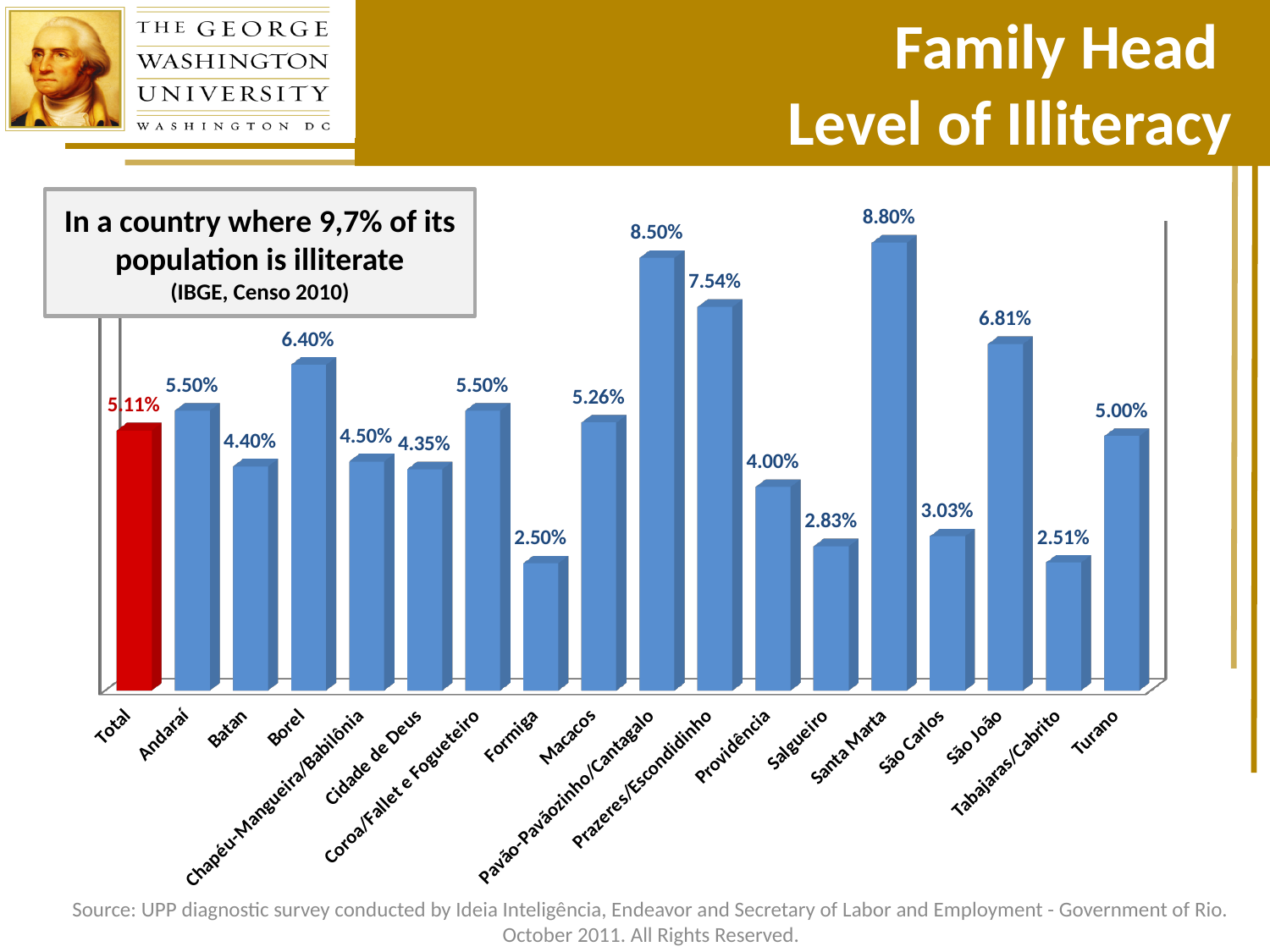
What is the illiteracy level for Santa Marta? 8.80% What is the difference between the Santa Marta value and the Total value? 3.69% Which community has the lowest level of illiteracy? Formiga What is the difference between Borel and Batan? 2.00% How many bars are shown in the chart? 18 What is the illiteracy level for Pavão-Pavãozinho/Cantagalo? 8.50% Which community has the highest level of illiteracy? Santa Marta Which is higher, São João or Borel? São João Which bar is coloured red instead of blue? Total What type of chart is shown on the slide? Bar chart What is the value shown for the Total bar? 5.11% What is the value for Tabajaras/Cabrito? 2.51%